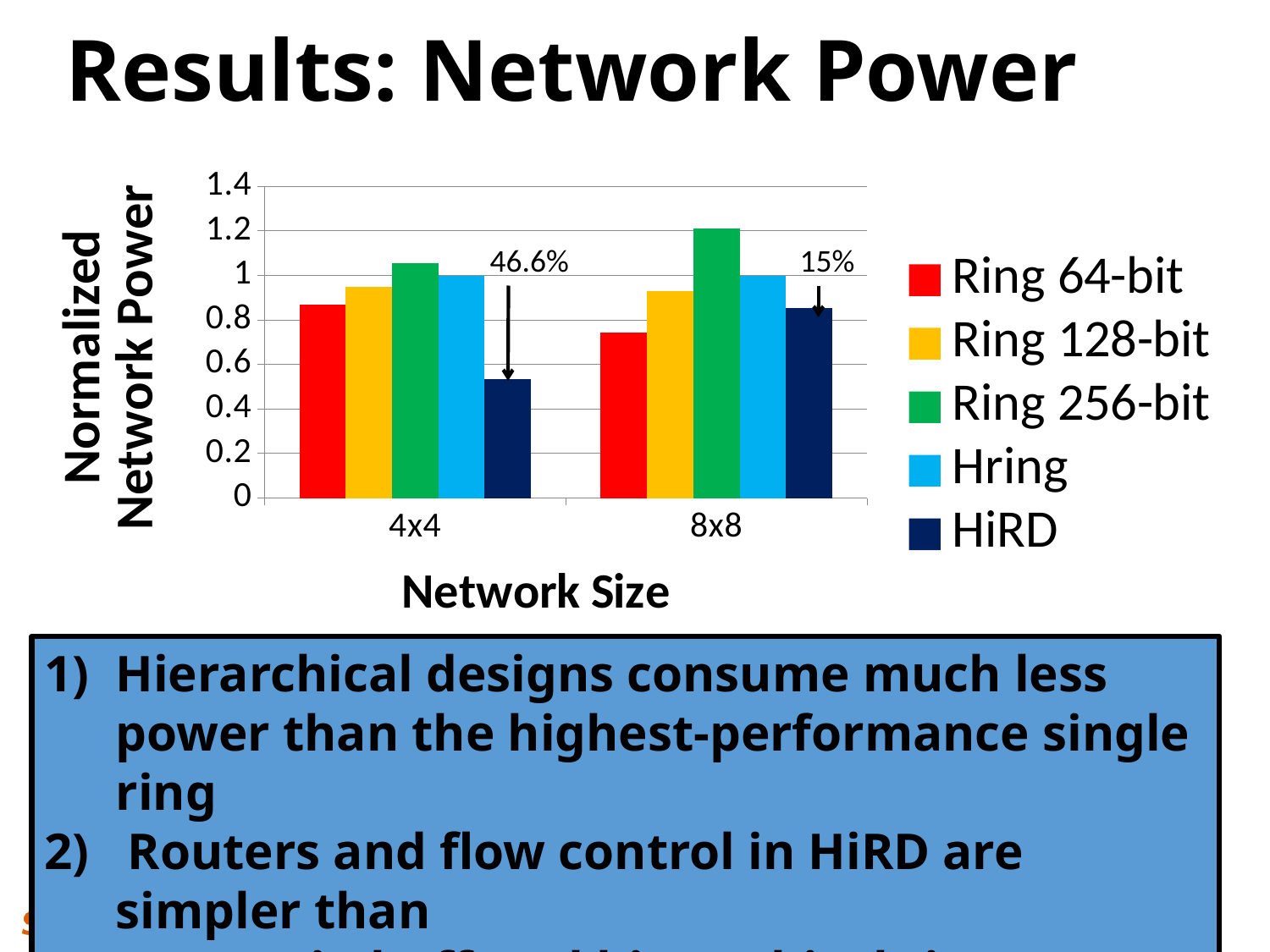
What kind of chart is shown on the slide? bar chart How many series does the legend list? 5 Which series has the lowest normalized network power for the 8x8 network size? Ring 64-bit Which series has the highest normalized network power for the 8x8 network size? Ring 256-bit How many network sizes are shown on the x axis? 2 What is the title of the x axis? Network Size Which is larger, the normalized network power for HiRD at 4x4 or at 8x8? 8x8 Is the normalized network power for Ring 256-bit at 8x8 greater or less than 1? greater Is the normalized network power for HiRD at 4x4 greater or less than 0.6? less What percentage is annotated above the HiRD bar for the 4x4 network size? 46.6% Is the normalized network power for Ring 64-bit at 8x8 greater or less than 0.8? less Which series has the lowest normalized network power for the 4x4 network size? HiRD